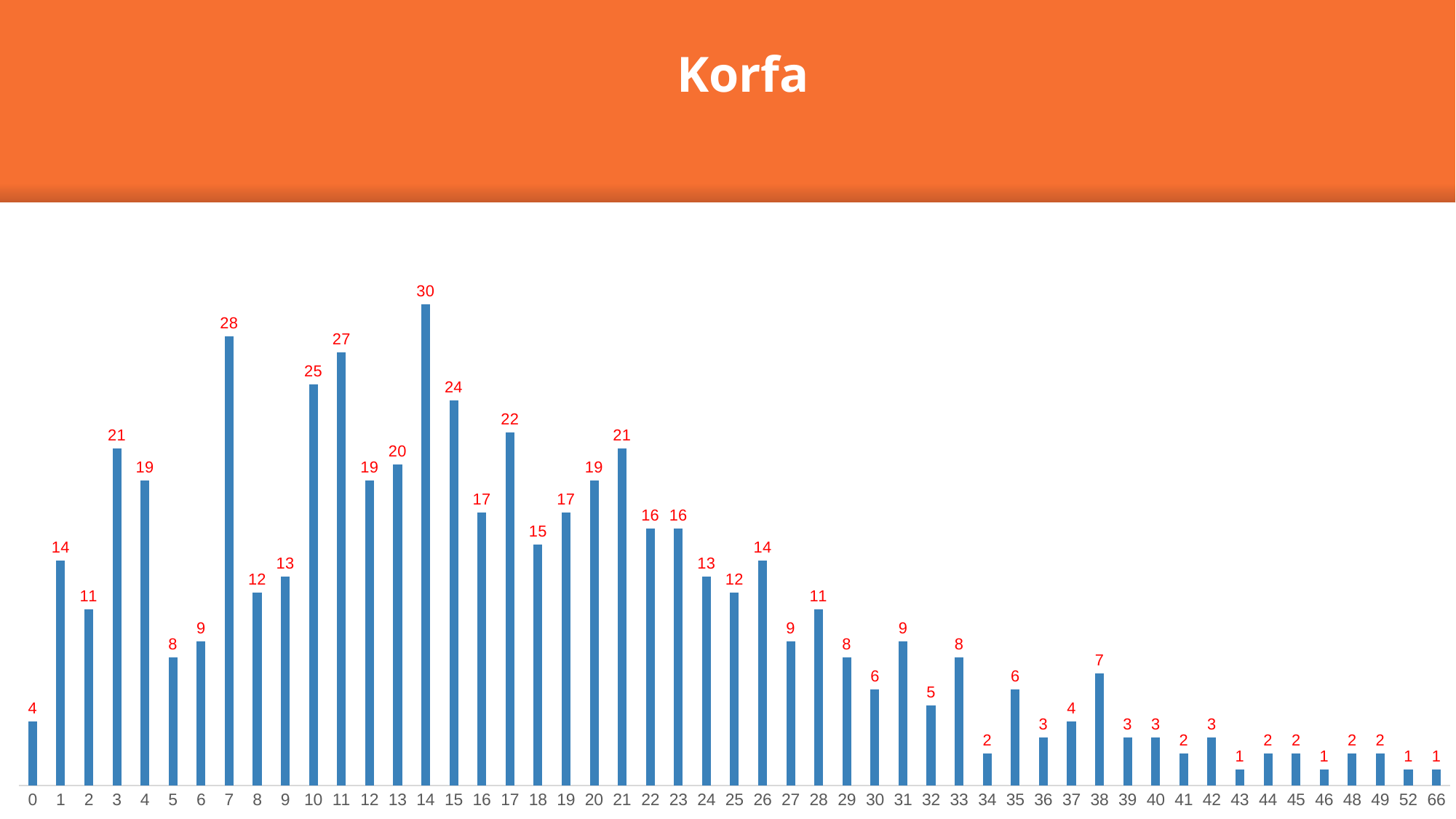
What is the value for category 0? 4 How many categories are shown on the x axis? 51 What kind of chart is shown? Bar chart What is the difference between the values for categories 14 and 15? 6 Which category has the highest value? 14 What is the value for category 38? 7 Do the values generally rise or fall from category 21 to category 30? Fall What is the value for category 22? 16 What is the difference between the values for categories 3 and 4? 2 Which has the larger value, category 10 or category 11? 11 What is the title of the slide? Korfa What is the value for category 7? 28